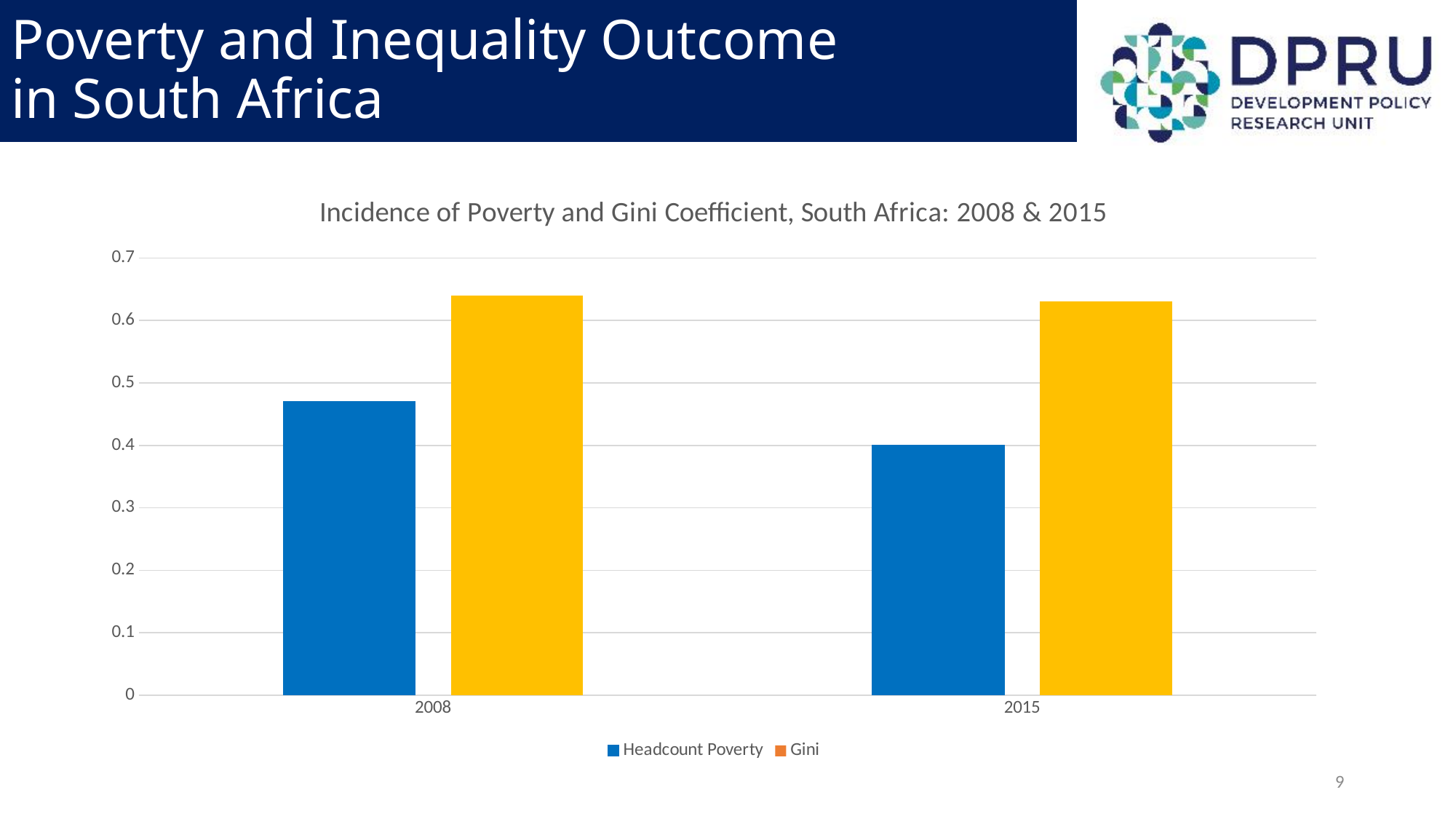
Is the Gini value for 2008 greater or less than 0.6? greater What kind of chart is shown on the slide? Bar chart In 2015, which is larger, Headcount Poverty or Gini? Gini What is the title of the chart? Incidence of Poverty and Gini Coefficient, South Africa: 2008 & 2015 Which year has the higher Headcount Poverty value, 2008 or 2015? 2008 Is the Gini value for 2015 greater or less than 0.7? less How many years are shown on the x axis? 2 Which two series are listed in the legend? Headcount Poverty and Gini How many series does the legend list? 2 Is the Headcount Poverty value for 2008 greater or less than 0.4? greater Does Headcount Poverty rise or fall from 2008 to 2015? Fall